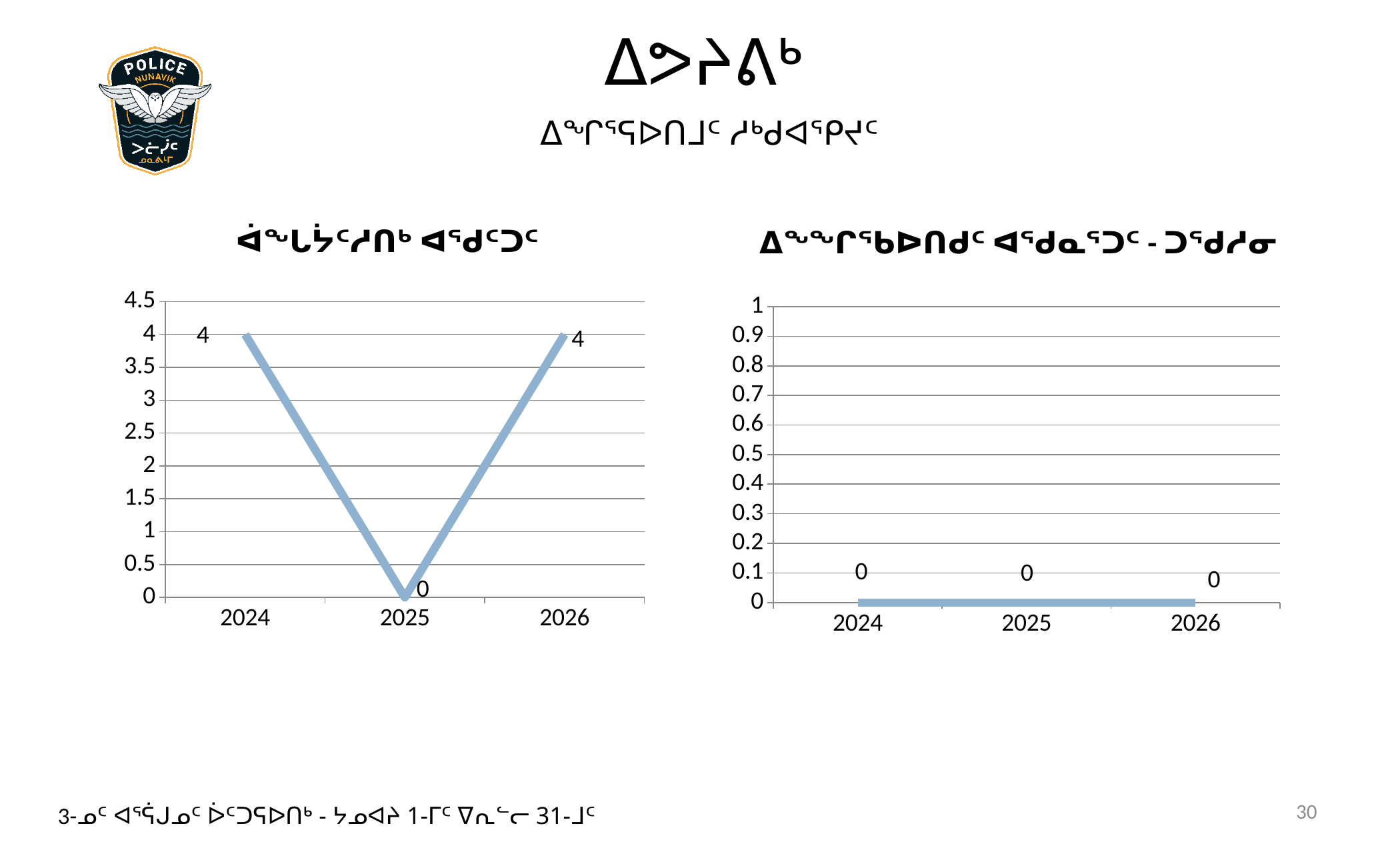
On the left chart, what is the value for 2026? 4 On the left chart, what is the value for 2024? 4 On the left chart, which year has the lowest value? 2025 On the left chart, what is the difference between the values for 2024 and 2025? 4 On the left chart, what is the value for 2025? 0 On the left chart, which year has the larger value, 2024 or 2025? 2024 On the right chart, what is the value for 2025? 0 On the right chart, how many years are plotted? 3 What kind of chart is the left chart? line chart On the left chart, how many years are plotted? 3 On the left chart, how do the values change from 2024 to 2026? fall then rise On the right chart, do the values rise, fall or stay the same from 2024 to 2026? stay the same